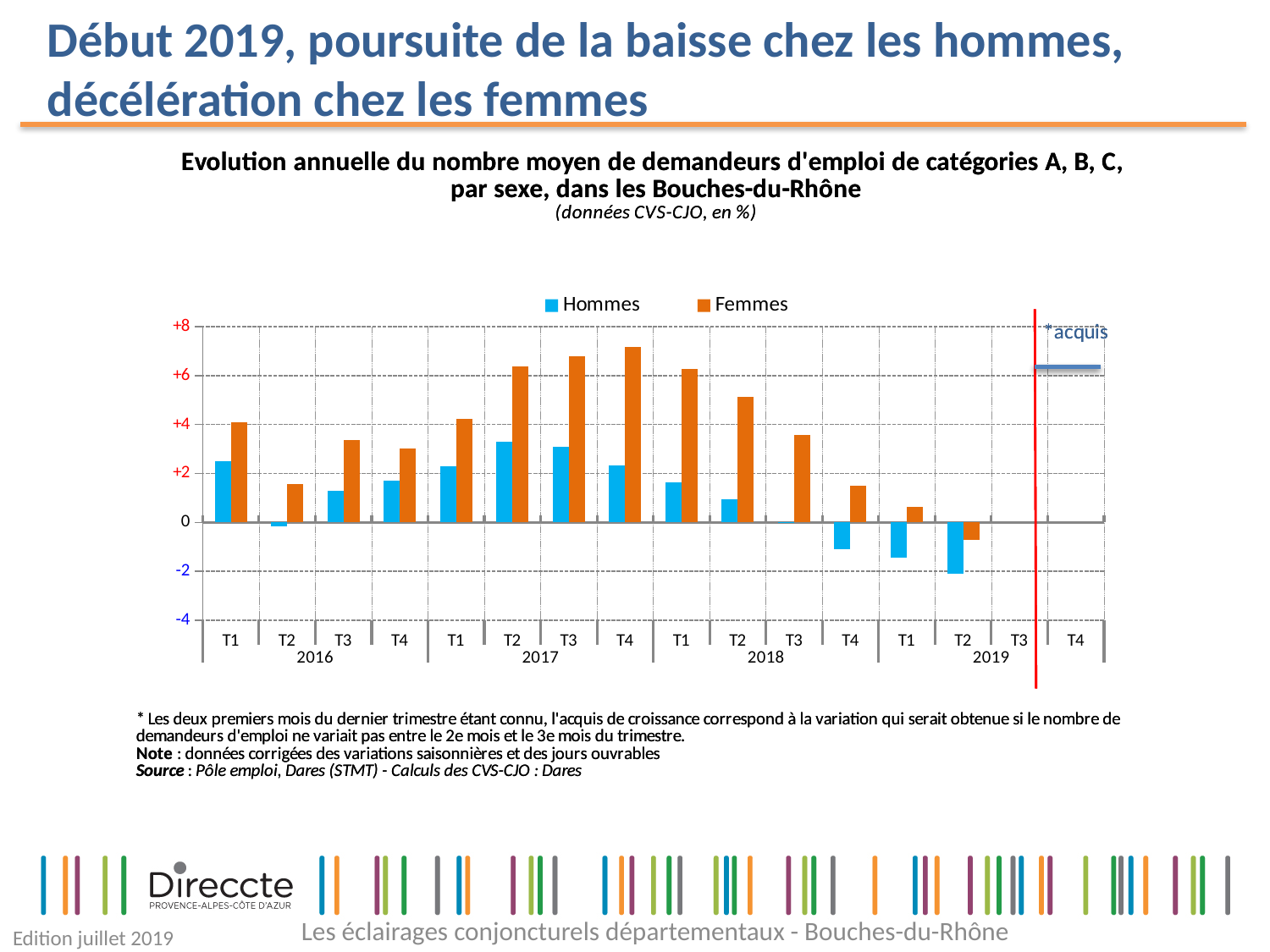
Is the value for Femmes in T2 2018 greater or less than +4? greater How many series does the legend list? 2 Which series is shown in orange in the legend? Femmes Does the Femmes series rise or fall from T4 2017 to T2 2019? fall In which quarter does the Femmes series reach its highest value? T4 2017 What kind of chart is shown on the slide? bar chart How many quarters are labelled on the x axis? 16 In which quarter does the Hommes series reach its lowest value? T2 2019 Is the value for Hommes in T4 2018 greater or less than 0? less In T1 2018, which series has the larger value, Hommes or Femmes? Femmes Is the value for Femmes in T4 2017 greater or less than +6? greater